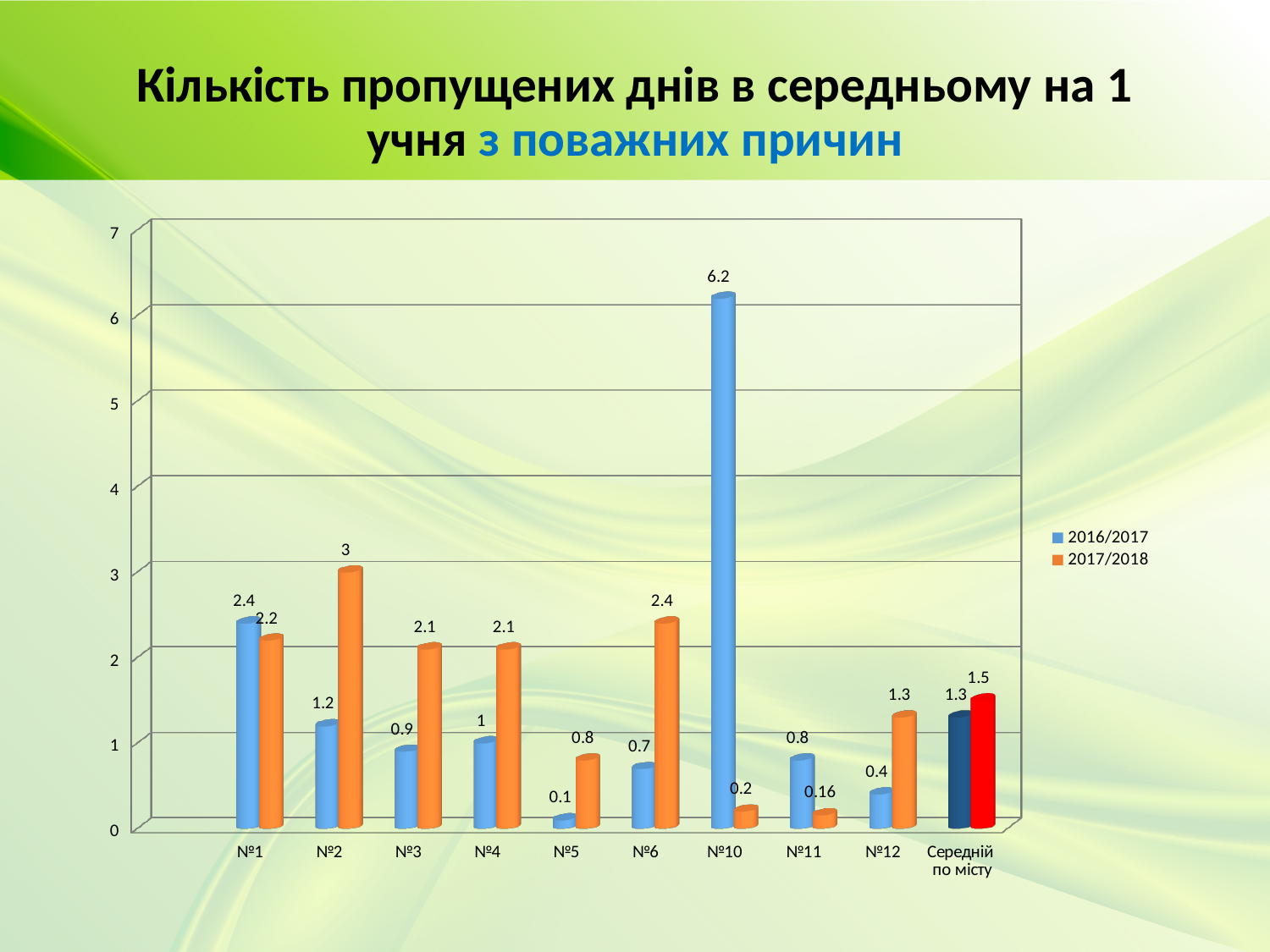
What is the 2017/2018 value for №11? 0.16 What is the difference between the 2017/2018 and 2016/2017 values for №6? 1.7 How many series does the legend list? 2 For №1, which series has the larger value, 2016/2017 or 2017/2018? 2016/2017 What is the 2017/2018 value for №2? 3 How many categories are shown on the x axis? 10 What is the 2016/2017 value for №10? 6.2 Which category has the highest 2016/2017 value? №10 Which series is shown in orange in the legend? 2017/2018 What is the 2017/2018 value for Середній по місту? 1.5 What type of chart is shown on the slide? bar chart Which category has the lowest 2017/2018 value? №11